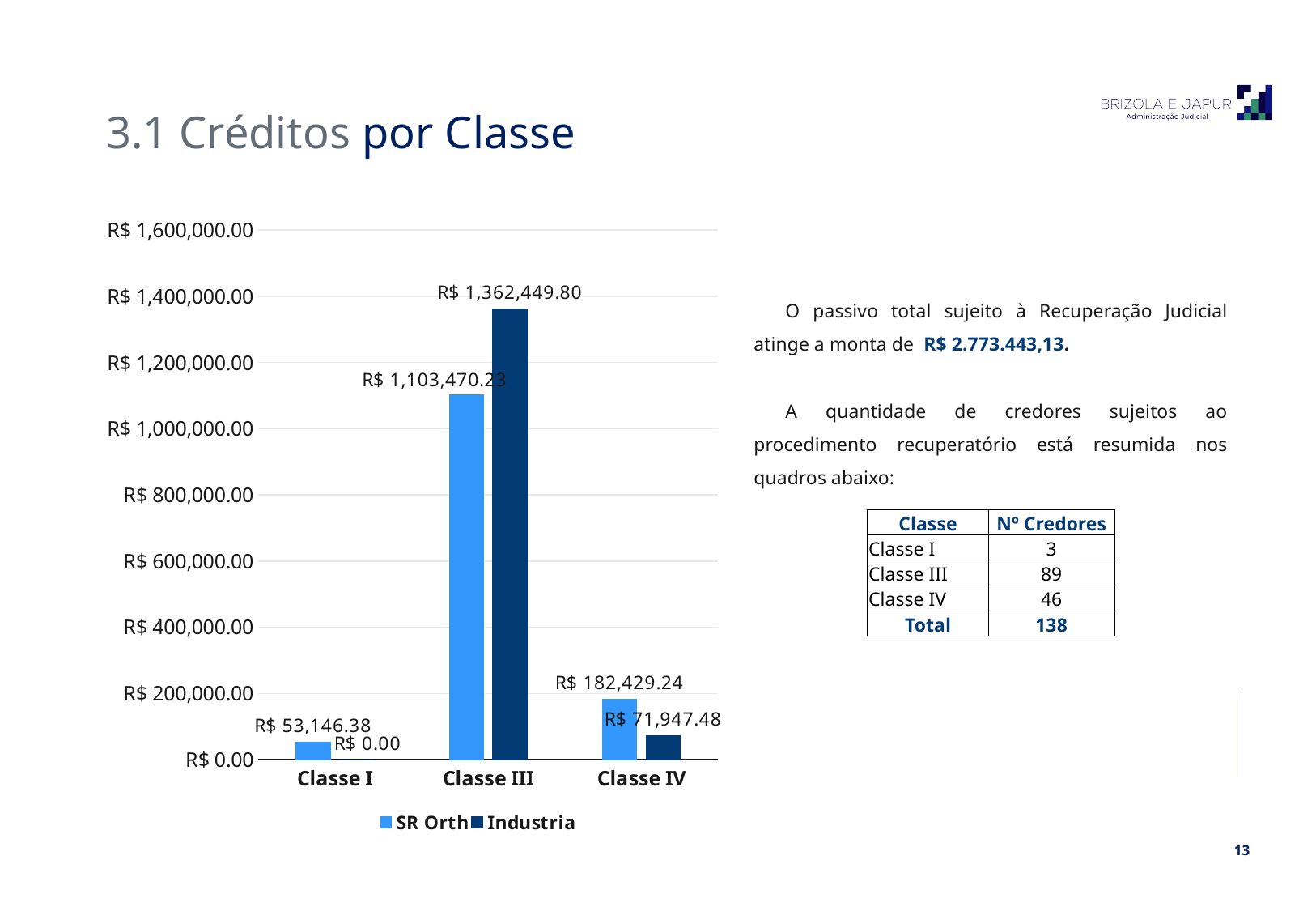
What kind of chart is shown on the slide? Bar chart What is the value for Industria in Classe IV? R$ 71,947.48 What is the value for SR Orth in Classe I? R$ 53,146.38 In Classe IV, which series has the larger value, SR Orth or Industria? SR Orth How many classes are shown on the x axis of the chart? 3 What is the value for Industria in Classe III? R$ 1,362,449.80 Which class has the lowest value for Industria? Classe I How many series does the chart legend list? 2 What is the value for Industria in Classe I? R$ 0.00 What is the difference between the Industria and SR Orth values in Classe III? R$ 258,979.57 What is the value for SR Orth in Classe III? R$ 1,103,470.23 Which class has the highest value for SR Orth? Classe III